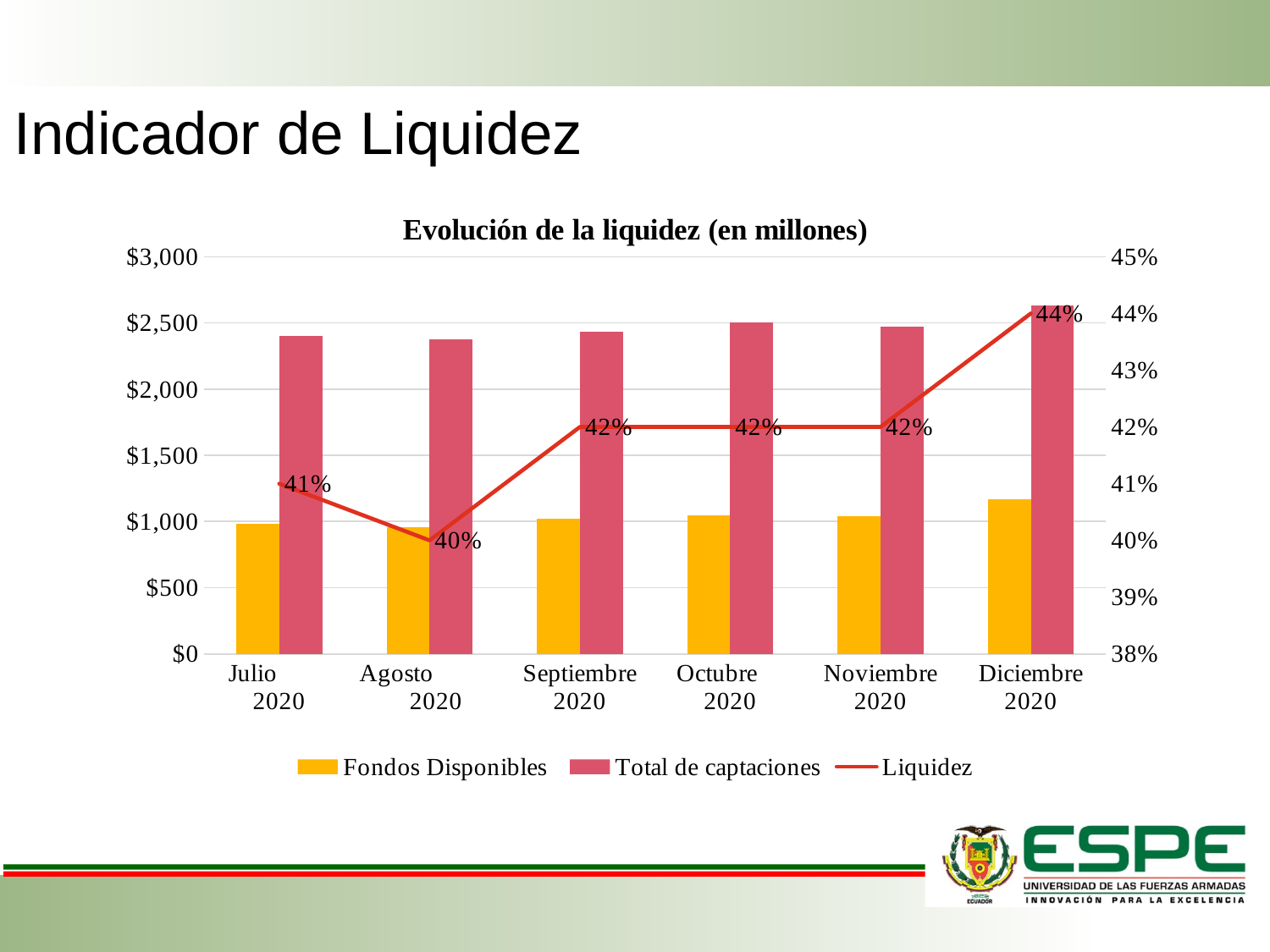
What is the Liquidez value for Agosto 2020? 40% What is the title of the chart? Evolución de la liquidez (en millones) Which month has a higher Liquidez value, Julio 2020 or Agosto 2020? Julio 2020 What is the Liquidez value for Julio 2020? 41% Is the Fondos Disponibles value for Julio 2020 greater or less than $1,500? less In which month is the Liquidez value lowest? Agosto 2020 In which month is the Liquidez value highest? Diciembre 2020 Is the Total de captaciones value for Julio 2020 greater or less than $2,000? greater How many series does the legend list? 3 What is the difference between the Liquidez value in Diciembre 2020 and in Agosto 2020? 4 percentage points What is the Liquidez value for Diciembre 2020? 44% How many months are shown on the x axis? 6